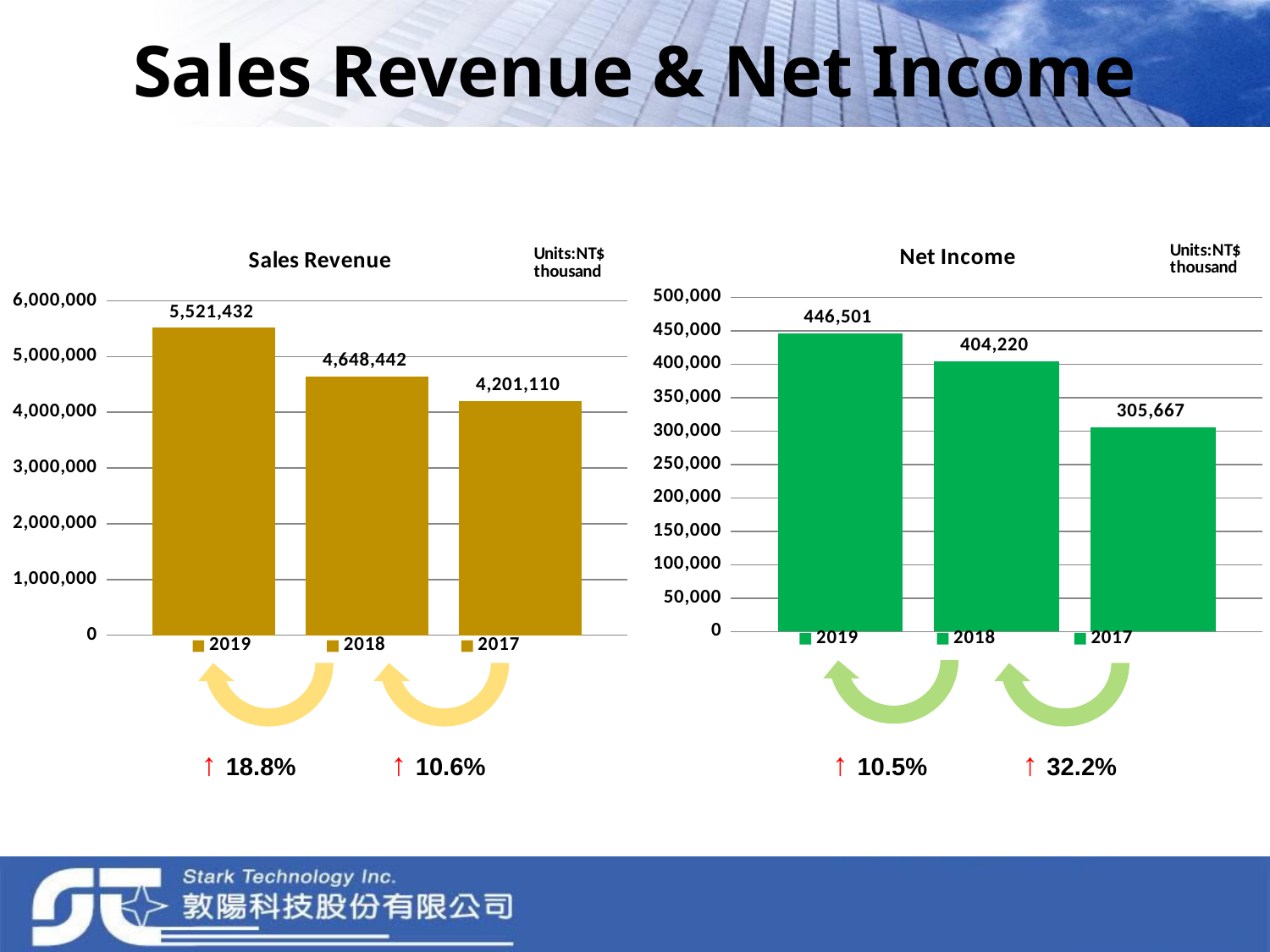
In the Sales Revenue chart, what is the value for 2017? 4,201,110 In the Net Income chart, what is the value for 2018? 404,220 In the Sales Revenue chart, which year has the highest value? 2019 In the Net Income chart, which year has the lowest value? 2017 In the Net Income chart, what is the value for 2017? 305,667 What type of chart is the Sales Revenue chart? bar chart In the Net Income chart, what is the difference between the 2019 and 2017 values? 140,834 How many bars are shown in the Net Income chart? 3 In the Sales Revenue chart, what is the difference between the 2019 and 2018 values? 872,990 In the Sales Revenue chart, is the value for 2018 greater or less than 5,000,000? less In the Net Income chart, which is larger, the value for 2018 or the value for 2017? 2018 In the Sales Revenue chart, what is the value for 2019? 5,521,432